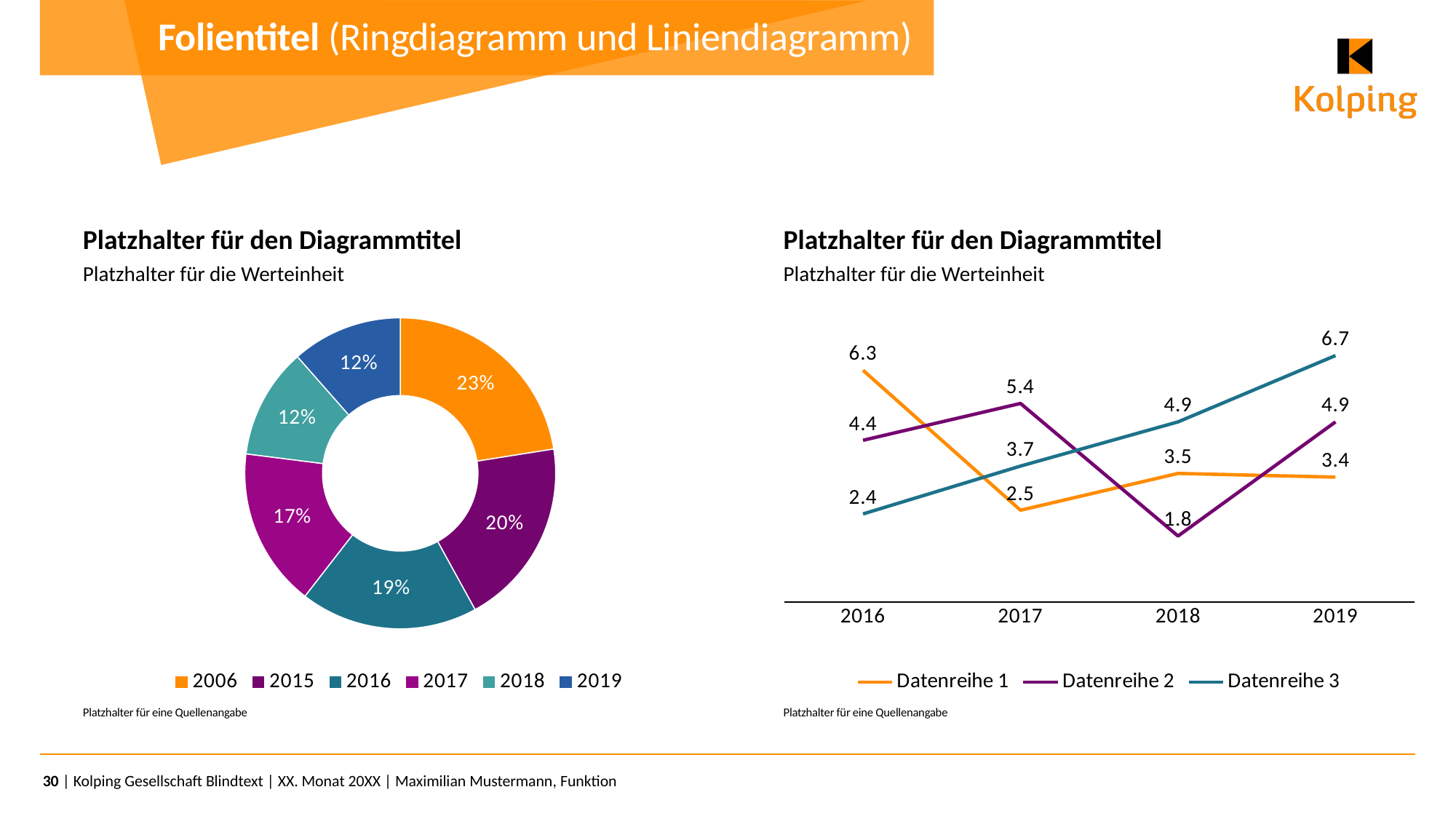
On the right chart (line chart), what is the value of Datenreihe 1 in 2016? 6.3 On the right chart (line chart), does Datenreihe 3 rise or fall from 2016 to 2019? Rise On the right chart (line chart), what is the difference between Datenreihe 3 and Datenreihe 1 in 2019? 3.3 What kind of chart is shown on the right side of the slide? Line chart On the left chart (doughnut), how many categories does the legend list? 6 On the left chart (doughnut), what share does 2006 have? 23% On the left chart (doughnut), which category has the largest share? 2006 On the left chart (doughnut), which is larger, the share of 2016 or the share of 2018? 2016 On the right chart (line chart), what is the value of Datenreihe 2 in 2018? 1.8 On the right chart (line chart), how many series does the legend list? 3 On the left chart (doughnut), what colour is the 2019 segment? Blue On the left chart (doughnut), what is the difference between the shares of 2015 and 2017? 3%